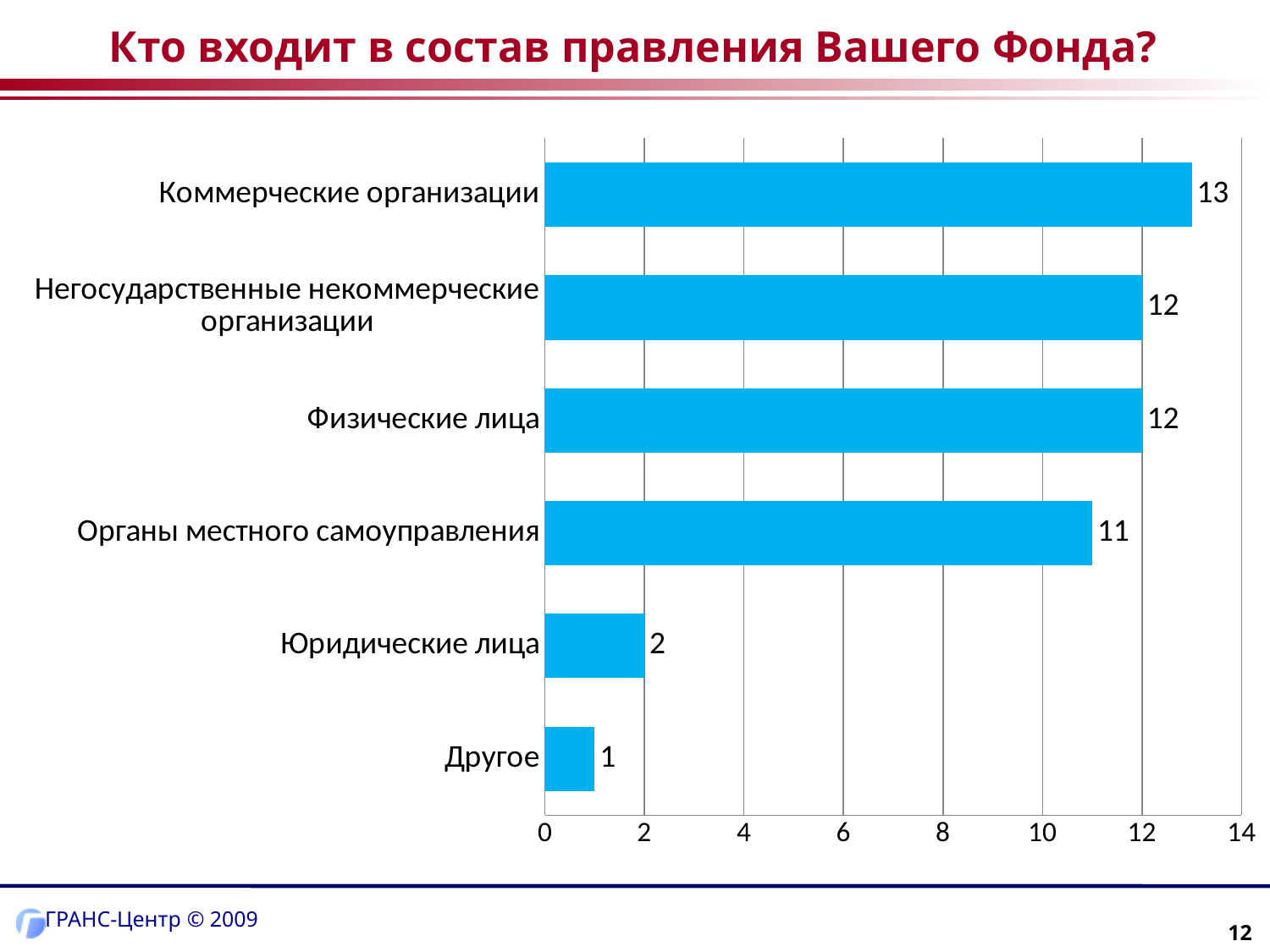
What is the title of the slide? Кто входит в состав правления Вашего Фонда? Which category has the lowest value? Другое How many categories are shown in the chart? 6 Which category has the highest value? Коммерческие организации Is the value for Негосударственные некоммерческие организации greater or less than 10? greater Which is larger, the value for Физические лица or the value for Юридические лица? Физические лица What kind of chart is shown on the slide? bar chart What is the value for Коммерческие организации? 13 What is the value for Органы местного самоуправления? 11 What is the value for Другое? 1 What is the value for Юридические лица? 2 What is the difference between the values for Коммерческие организации and Органы местного самоуправления? 2